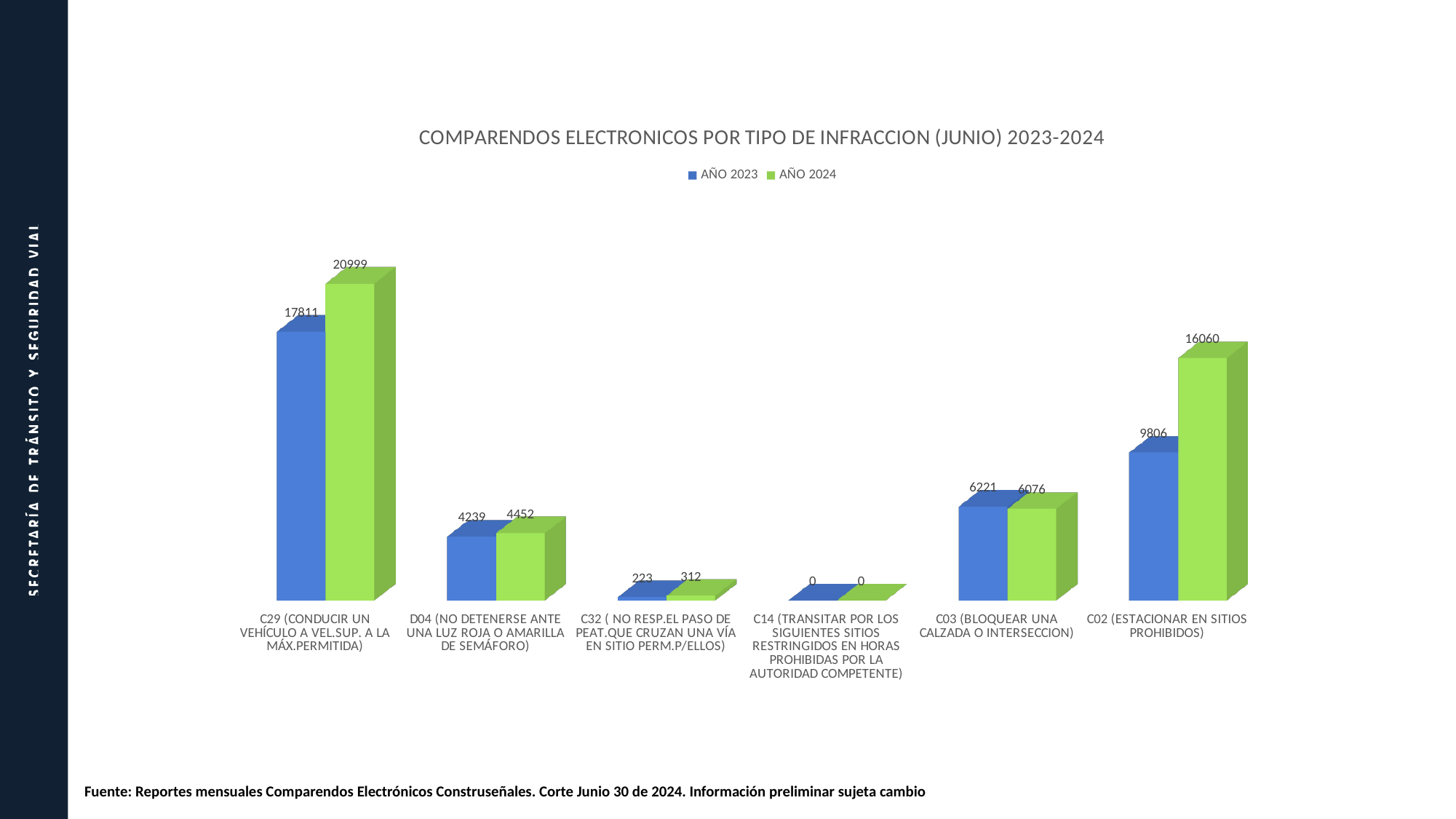
What is the value for C03 (BLOQUEAR UNA CALZADA O INTERSECCION) in AÑO 2024? 6076 How many infraction categories are shown on the x axis? 6 What is the difference between the AÑO 2024 and AÑO 2023 values for C02 (ESTACIONAR EN SITIOS PROHIBIDOS)? 6254 What is the value for C29 (CONDUCIR UN VEHÍCULO A VEL.SUP. A LA MÁX.PERMITIDA) in AÑO 2024? 20999 Which category has the highest value in AÑO 2023? C29 (CONDUCIR UN VEHÍCULO A VEL.SUP. A LA MÁX.PERMITIDA) What kind of chart is shown on the slide? Bar chart How many series does the legend list? 2 Which category has the lowest value in AÑO 2024? C14 (TRANSITAR POR LOS SIGUIENTES SITIOS RESTRINGIDOS EN HORAS PROHIBIDAS POR LA AUTORIDAD COMPETENTE) For C03 (BLOQUEAR UNA CALZADA O INTERSECCION), which year has the larger value, AÑO 2023 or AÑO 2024? AÑO 2023 What is the value for C02 (ESTACIONAR EN SITIOS PROHIBIDOS) in AÑO 2023? 9806 For D04 (NO DETENERSE ANTE UNA LUZ ROJA O AMARILLA DE SEMÁFORO), which year has the larger value, AÑO 2023 or AÑO 2024? AÑO 2024 What is the difference between the AÑO 2024 and AÑO 2023 values for C29 (CONDUCIR UN VEHÍCULO A VEL.SUP. A LA MÁX.PERMITIDA)? 3188